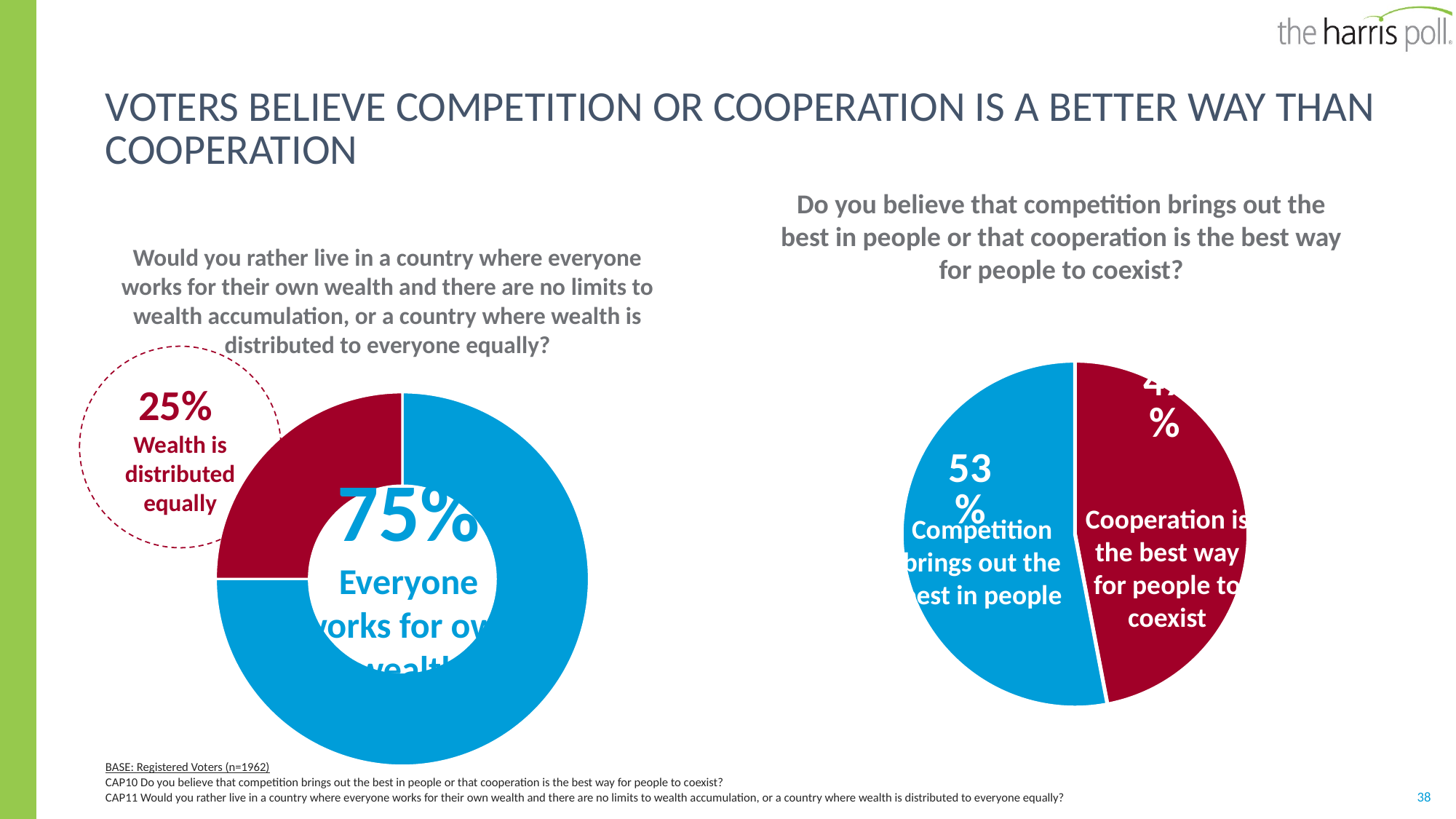
In the left chart (Would you rather live in a country...), how many percentage points larger is 'Everyone works for own wealth' than 'Wealth is distributed equally'? 50 percentage points In the right chart (Do you believe that competition brings out the best in people...), which response has the larger share: 'Competition brings out the best in people' or 'Cooperation is the best way for people to coexist'? Competition brings out the best in people What kind of chart is the right chart (Do you believe that competition brings out the best in people...)? Pie chart In the left chart (Would you rather live in a country...), how many response categories are shown? 2 In the right chart (Do you believe that competition brings out the best in people...), what percentage of voters said 'Competition brings out the best in people'? 53% In the right chart (Do you believe that competition brings out the best in people...), what colour is the 'Cooperation is the best way for people to coexist' slice? Red In the right chart (Do you believe that competition brings out the best in people...), how many slices does the pie have? 2 In the right chart (Do you believe that competition brings out the best in people...), is the share for 'Competition brings out the best in people' greater or less than 50%? greater In the left chart (Would you rather live in a country...), what percentage of voters chose 'Everyone works for own wealth'? 75% In the left chart (Would you rather live in a country...), which response has the largest share? Everyone works for own wealth What kind of chart is the left chart (Would you rather live in a country...)? Donut (pie) chart In the left chart (Would you rather live in a country...), what percentage of voters chose 'Wealth is distributed equally'? 25%